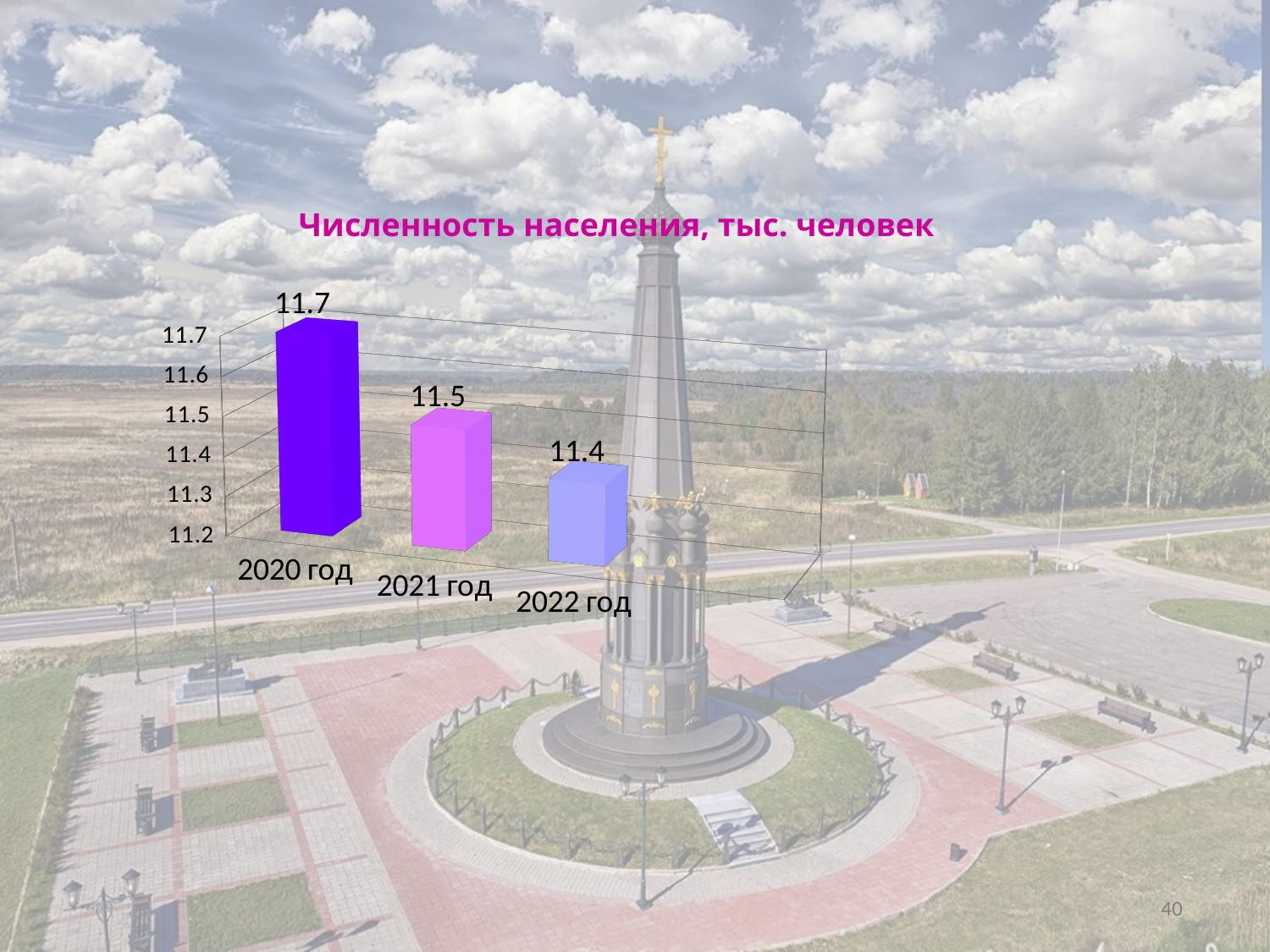
How many years (categories) are shown in the chart? 3 Do the values rise or fall from 2020 год to 2022 год? fall What is the difference between the values for 2020 год and 2022 год? 0.3 Which year has the lowest population value? 2022 год What is the population value shown for 2021 год? 11.5 What is the population value shown for 2020 год? 11.7 What is the difference between the values for 2021 год and 2022 год? 0.1 What is the title of the chart? Численность населения, тыс. человек What kind of chart is shown on the slide? bar chart What is the population value shown for 2022 год? 11.4 Which year has the highest population value? 2020 год Which is larger, the value for 2020 год or the value for 2021 год? 2020 год